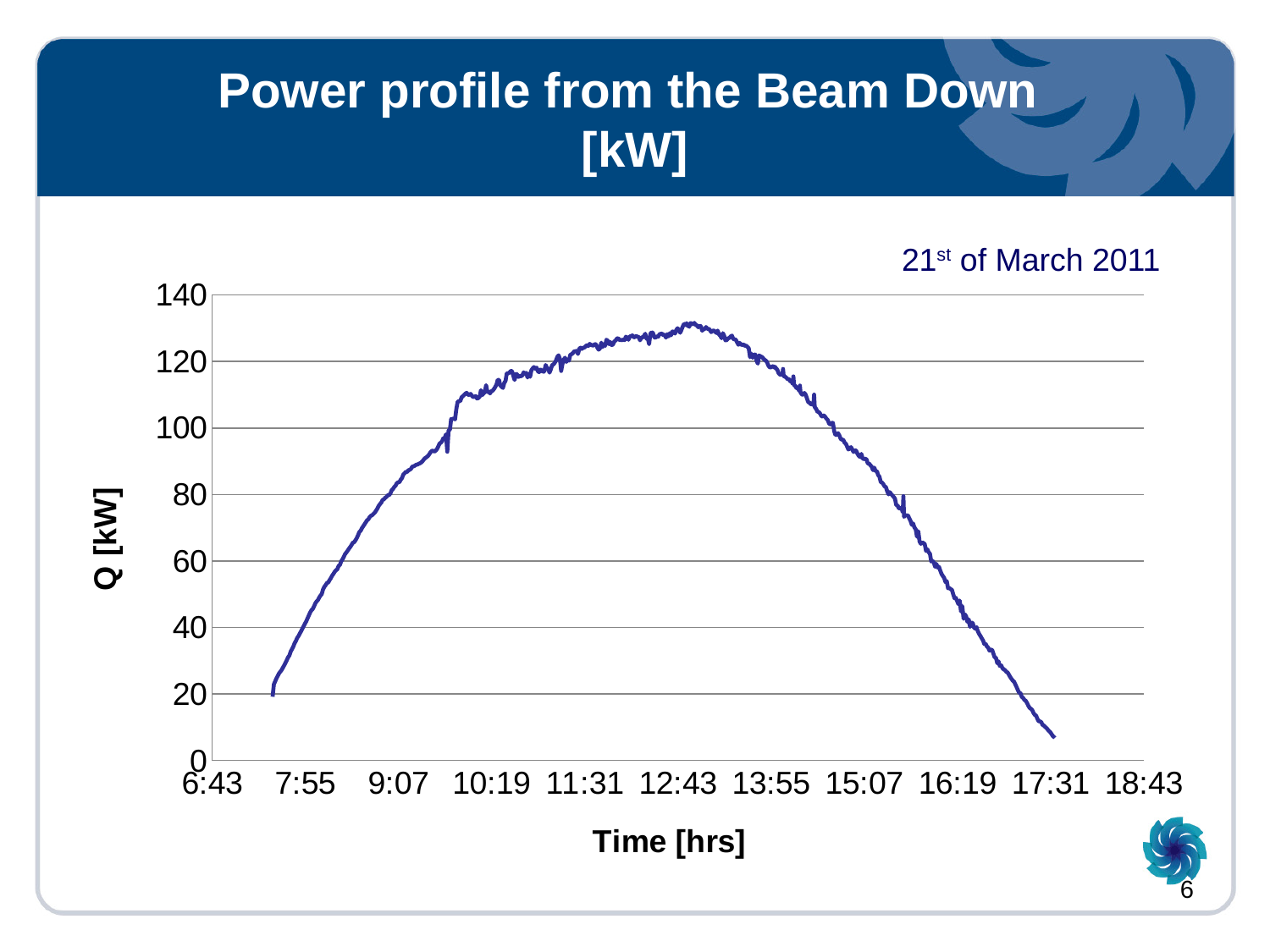
Is the value of Q at 15:07 greater or less than 100? less How many time labels are shown on the x axis? 11 Is the value of Q at 9:07 greater or less than 60? greater What date is given for the power profile on the slide? 21st of March 2011 What kind of chart is shown on the slide? line chart Is the value of Q at 16:19 greater or less than 60? less Around which x-axis tick does the line reach its highest value? 12:43 Does the power rise or fall between 13:55 and 17:31? fall Does the power rise or fall between 7:55 and 12:43? rise